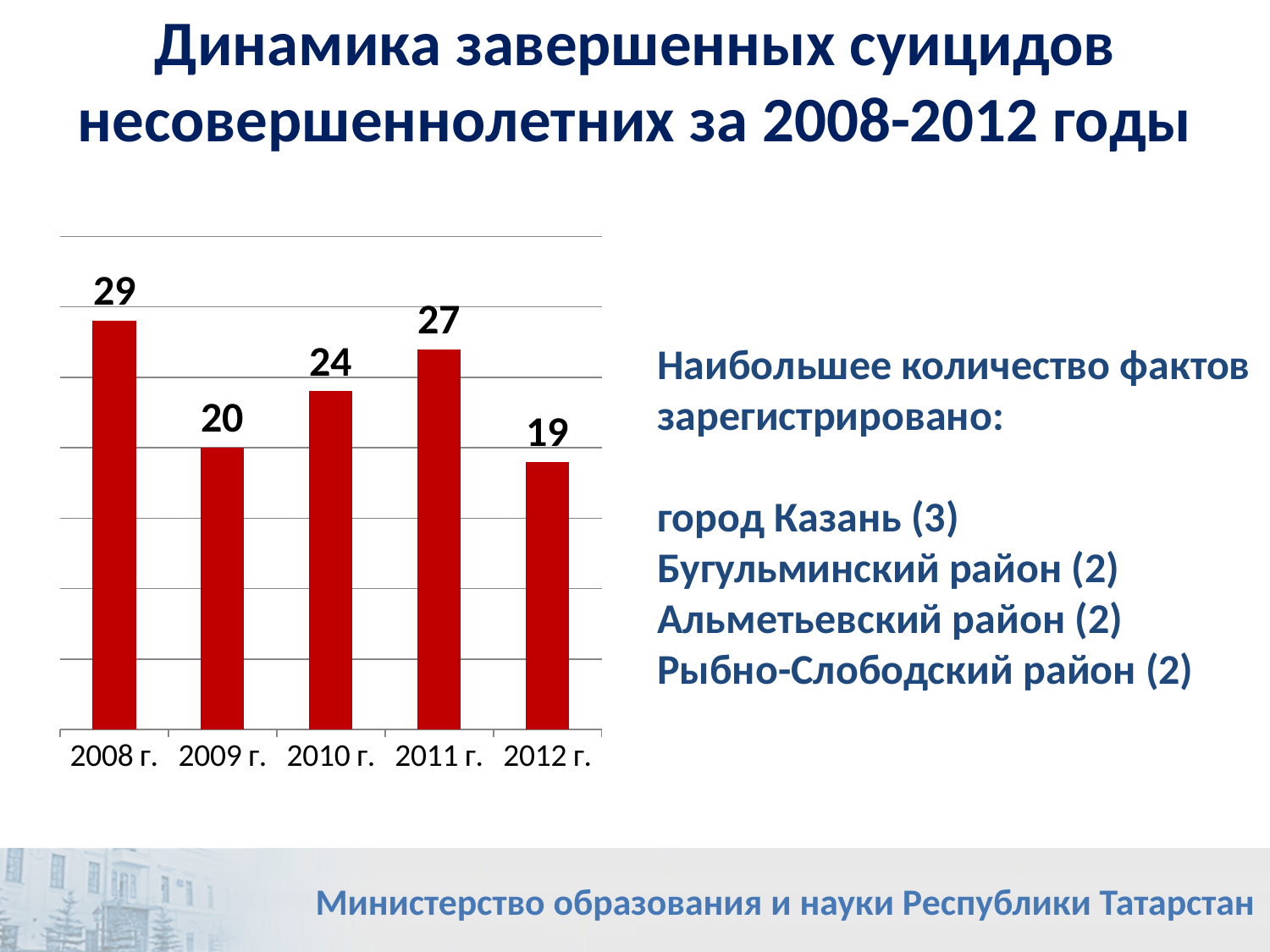
How many years are shown on the chart? 5 What kind of chart is shown on the slide? Bar chart What colour are the bars in the chart? Red Which is larger, the value for 2010 г. or the value for 2011 г.? 2011 г. What is the value for 2012 г.? 19 Which year has the lowest value? 2012 г. What is the difference between the values for 2011 г. and 2012 г.? 8 Does the value rise or fall from 2011 г. to 2012 г.? Fall What is the value for 2008 г.? 29 What is the value for 2010 г.? 24 What is the difference between the values for 2008 г. and 2009 г.? 9 Which year has the highest value? 2008 г.